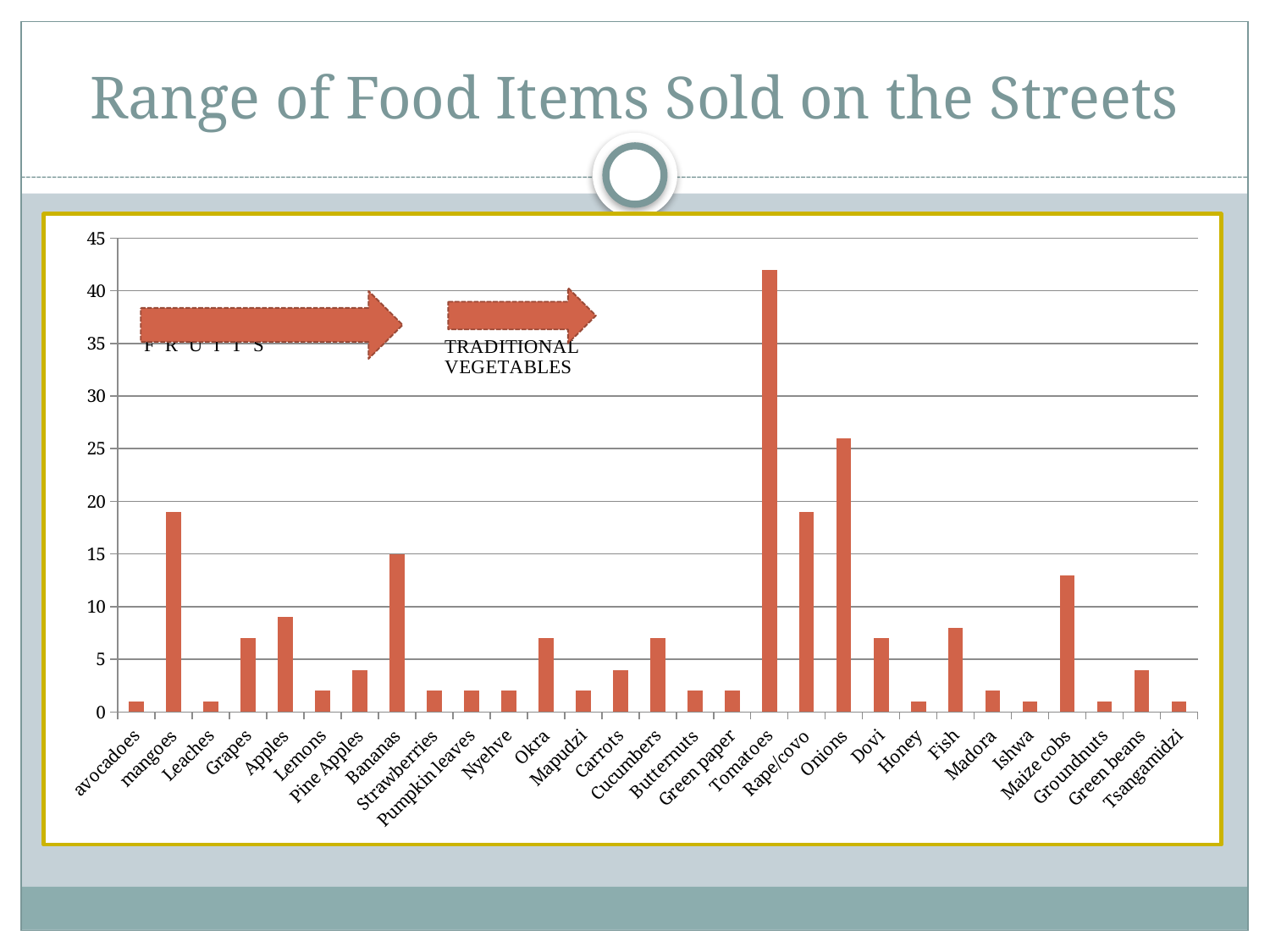
Is the value for Tomatoes greater or less than 40? greater What two group labels are written next to the arrows drawn on the chart? FRUITS and TRADITIONAL VEGETABLES How many food item categories are shown on the x axis? 29 Is the value for Onions greater or less than 25? greater What type of chart is shown on the slide? Bar chart What is the title of the slide's chart? Range of Food Items Sold on the Streets Which has the larger value, Onions or Rape/covo? Onions Is the value for Apples greater or less than 10? less Which food item has the highest bar in the chart? Tomatoes Which has the larger value, Bananas or Maize cobs? Bananas